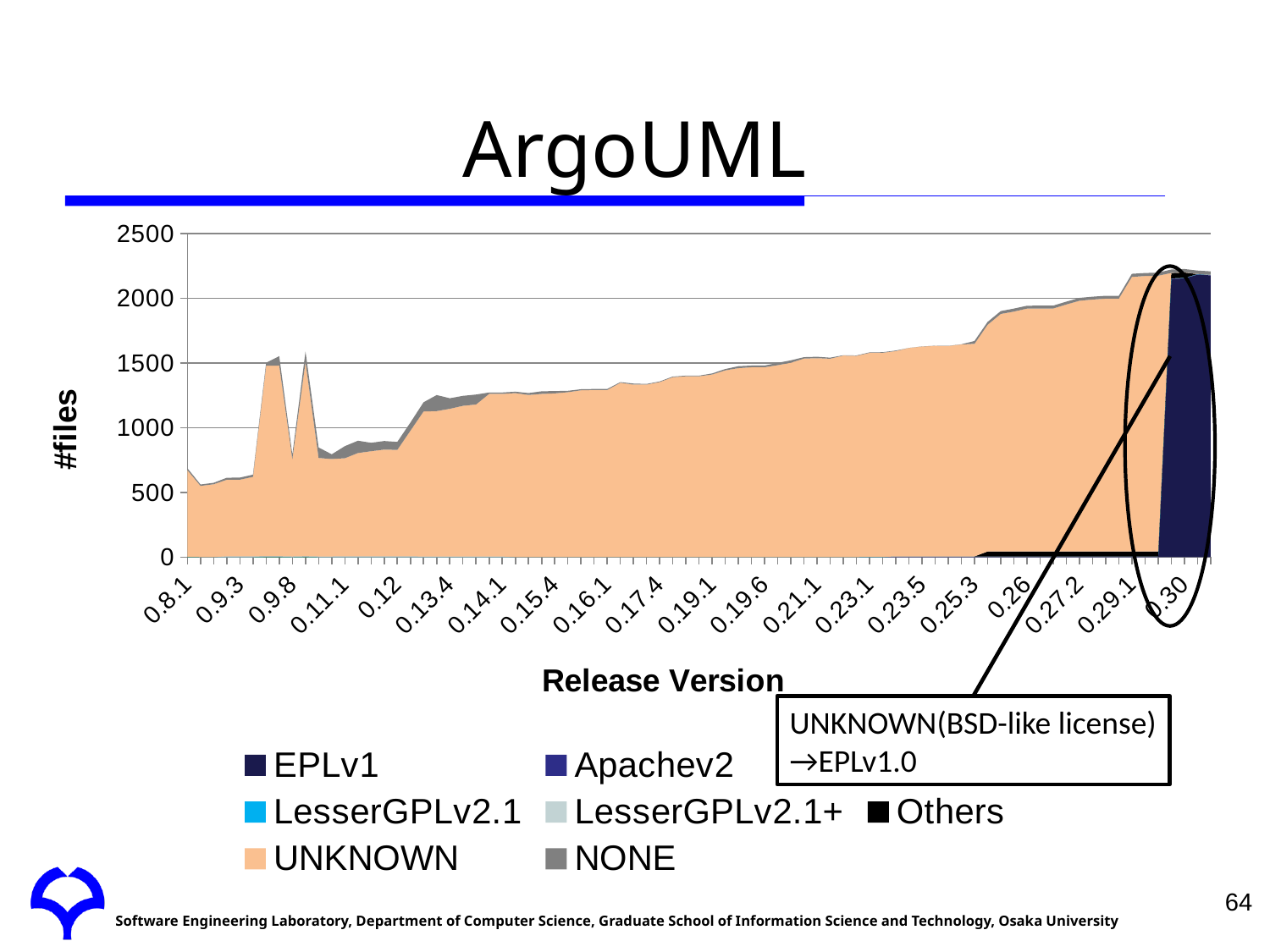
How many series does the legend list? 7 What kind of chart is shown on the slide? Stacked area chart Is the total number of files at release 0.26 greater or less than 1500? greater Is the total number of files at release 0.8.1 greater or less than 1000? less Is the total number of files at release 0.9.3 greater or less than 1000? less What is the title of the chart? ArgoUML Overall, does the total number of files rise or fall from release 0.8.1 to release 0.30? rise What is the label of the y axis? #files Which series accounts for almost all files at release 0.30? EPLv1 What is the highest value shown on the y axis? 2500 Which series accounts for almost all files in the releases before 0.30? UNKNOWN